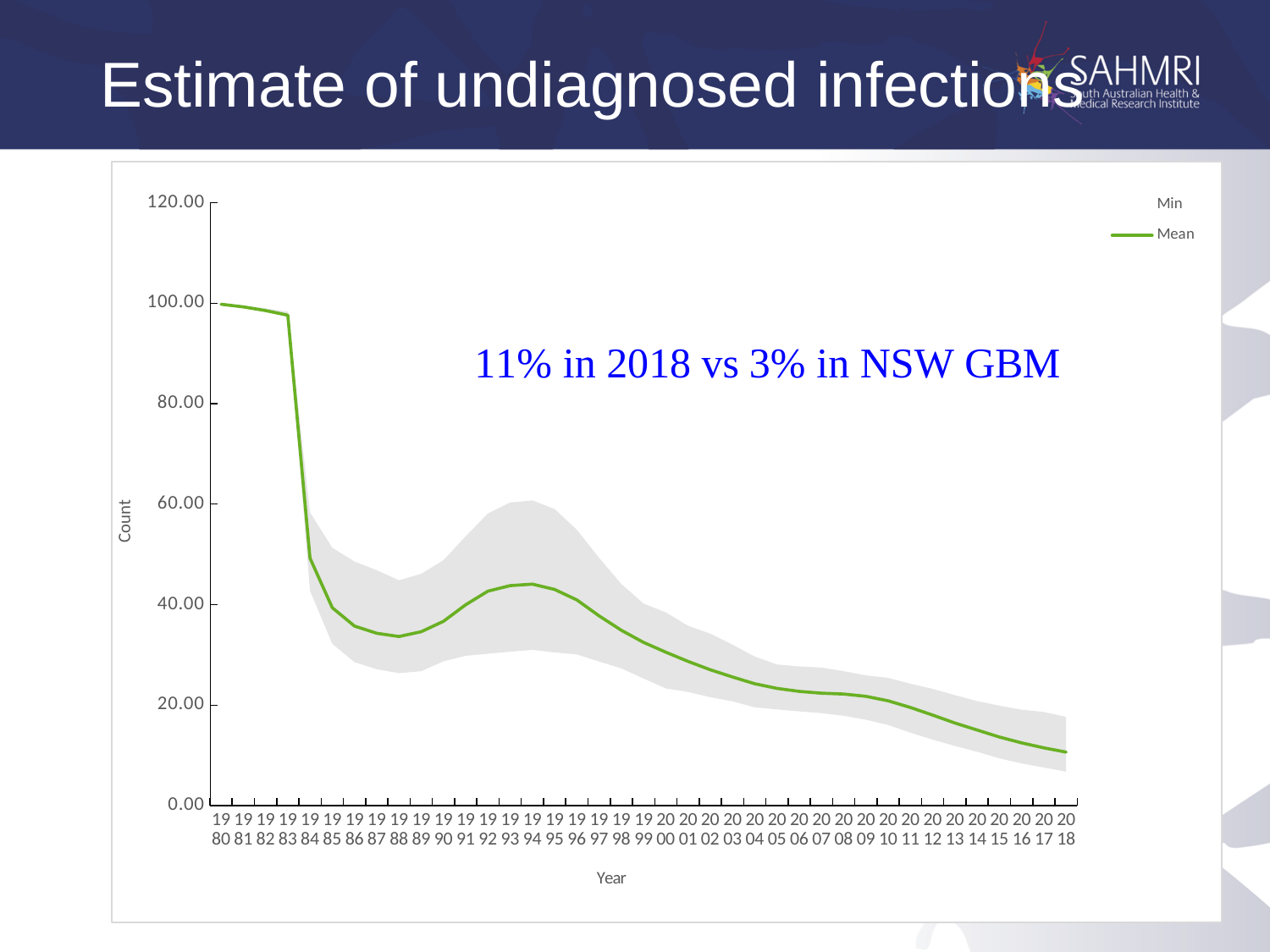
Is the Mean value for 2005 greater or less than 40.00? less In which year is the Mean line at its lowest value? 2018 Is the Mean value for 1980 greater or less than 80.00? greater In which year is the Mean line at its highest value? 1980 Overall, does the Mean line rise or fall from 1980 to 2018? fall What kind of chart is shown on the slide? line chart Which year has a higher Mean value, 1994 or 1988? 1994 What is the title of the slide's chart? Estimate of undiagnosed infections What is the label on the vertical axis of the chart? Count Is the Mean value for 2018 greater or less than 20.00? less How many entries does the chart's legend list? 2 How many years are shown along the x axis of the chart? 39